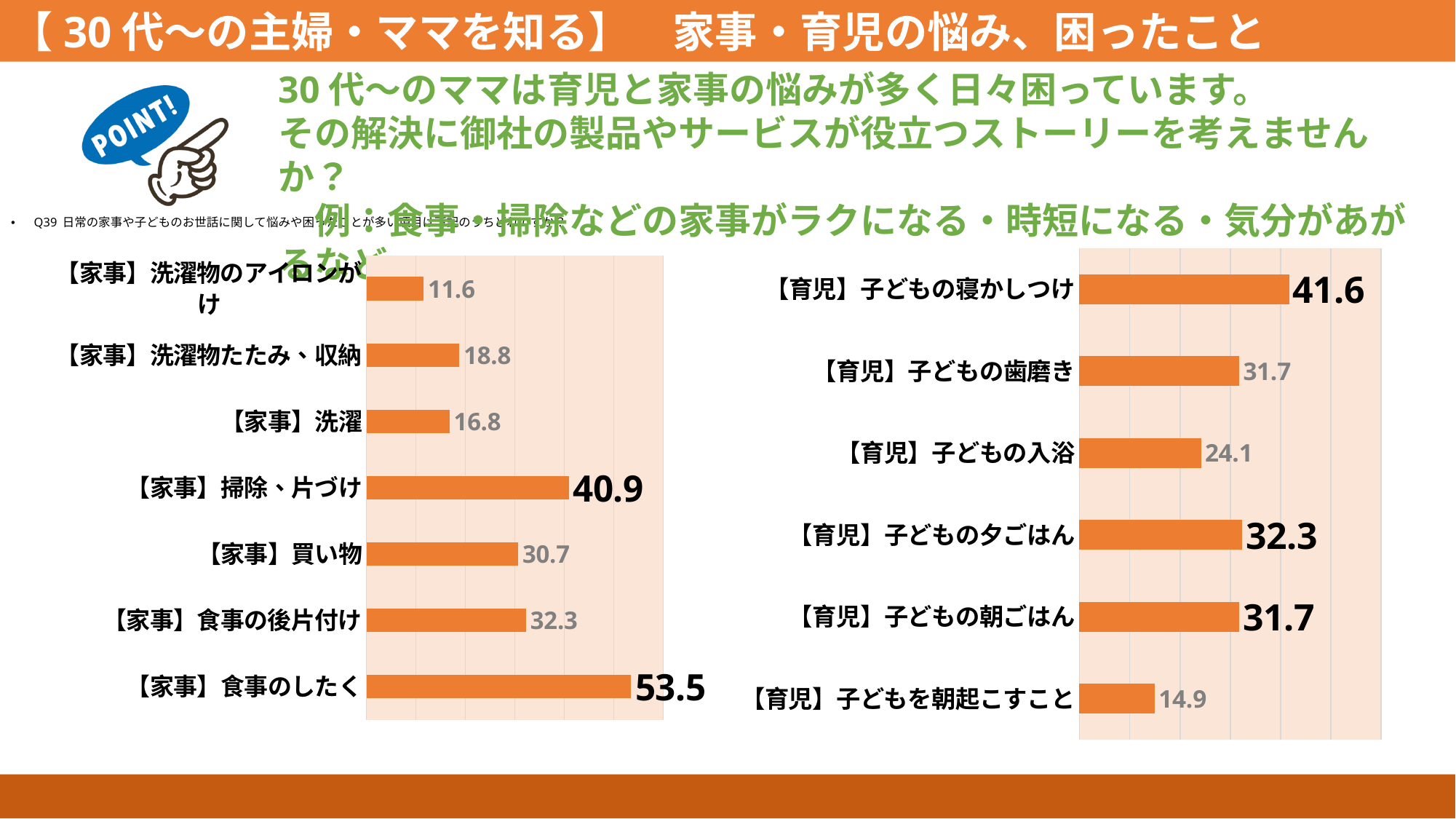
In the right chart, what is the value for 【育児】子どもの入浴? 24.1 In the right chart, which category has the highest value? 【育児】子どもの寝かしつけ What kind of chart is the right chart? Bar chart In the right chart, which category has the lowest value? 【育児】子どもを朝起こすこと In the left chart, what is the difference between the values for 【家事】食事のしたく and 【家事】掃除、片づけ? 12.6 In the left chart, what is the value for 【家事】洗濯物たたみ、収納? 18.8 In the right chart, which is larger, the value for 【育児】子どもの夕ごはん or 【育児】子どもの入浴? 【育児】子どもの夕ごはん In the left chart, what is the value for 【家事】食事のしたく? 53.5 In the left chart, which category has the lowest value? 【家事】洗濯物のアイロンがけ In the right chart, what is the value for 【育児】子どもを朝起こすこと? 14.9 In the left chart, which category has the highest value? 【家事】食事のしたく How many categories does the left chart show? 7